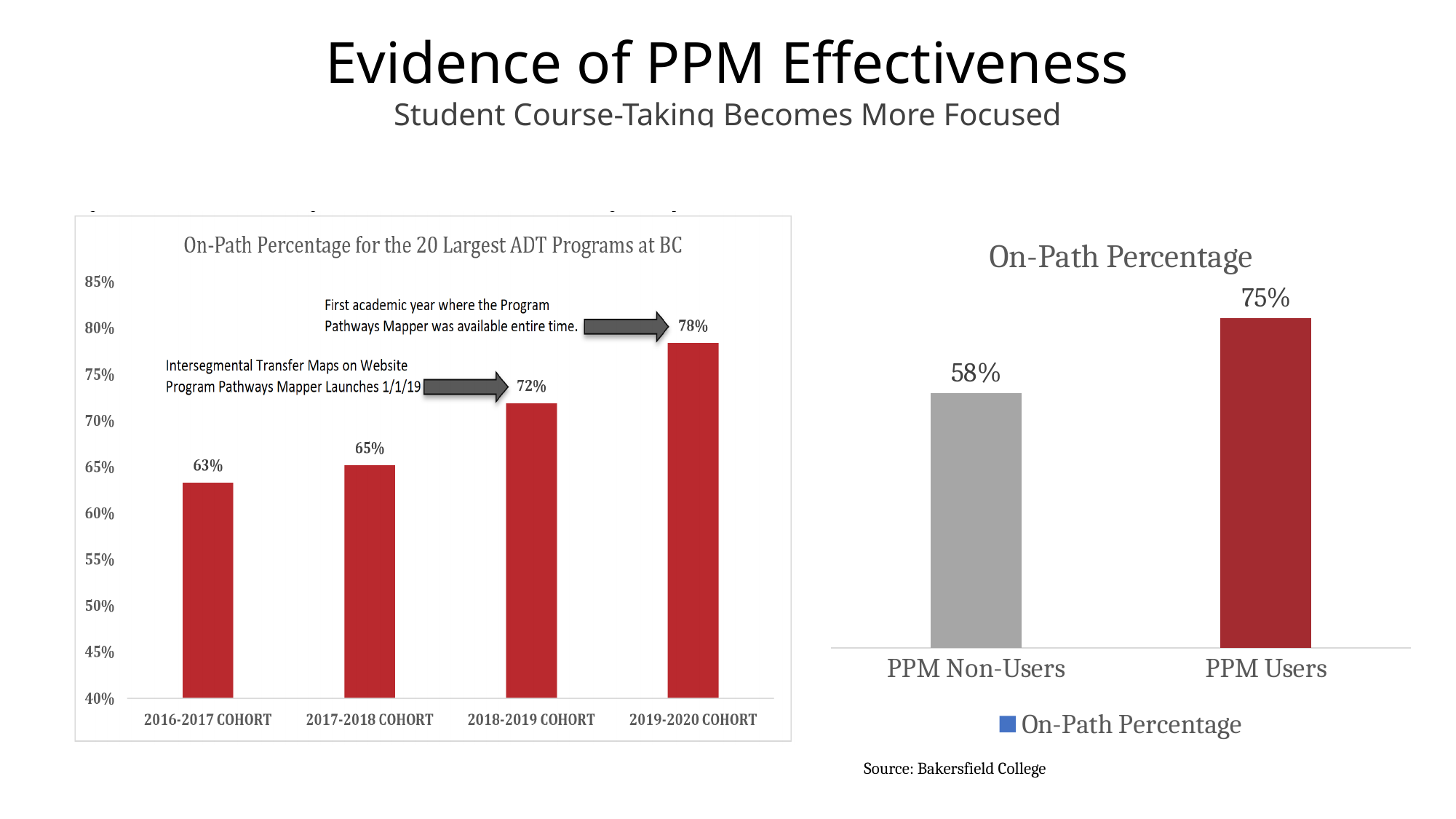
In the chart titled 'On-Path Percentage for the 20 Largest ADT Programs at BC', which cohort has the lowest on-path percentage? 2016-2017 COHORT In the chart titled 'On-Path Percentage for the 20 Largest ADT Programs at BC', what is the value for the 2016-2017 COHORT? 63% In the chart titled 'On-Path Percentage for the 20 Largest ADT Programs at BC', what is the value for the 2019-2020 COHORT? 78% In the chart titled 'On-Path Percentage' on the right, what is the difference between PPM Users and PPM Non-Users? 17% In the chart titled 'On-Path Percentage' on the right, how many series does the legend list? 1 In the chart titled 'On-Path Percentage for the 20 Largest ADT Programs at BC', do the values rise or fall from the 2016-2017 COHORT to the 2019-2020 COHORT? rise In the chart titled 'On-Path Percentage for the 20 Largest ADT Programs at BC', what kind of chart is used? bar chart In the chart titled 'On-Path Percentage for the 20 Largest ADT Programs at BC', what is the difference between the 2019-2020 COHORT and the 2018-2019 COHORT values? 6% In the chart titled 'On-Path Percentage' on the right, which group has the higher on-path percentage, PPM Users or PPM Non-Users? PPM Users In the chart titled 'On-Path Percentage' on the right, what is the value for PPM Users? 75% In the chart titled 'On-Path Percentage' on the right, what is the value for PPM Non-Users? 58% In the chart titled 'On-Path Percentage for the 20 Largest ADT Programs at BC', how many cohorts are shown? 4